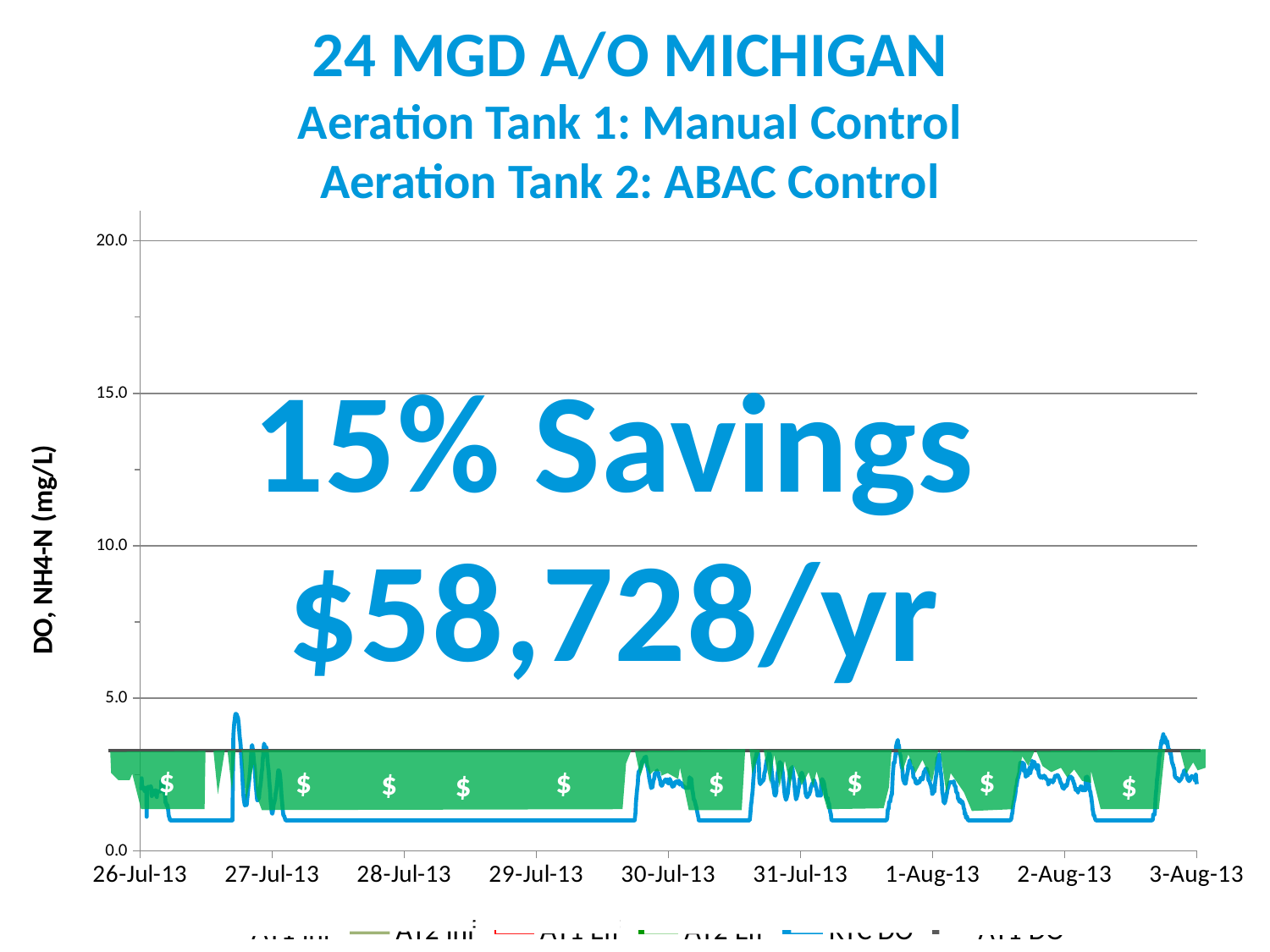
Does the blue line ever rise above 10.0 on the chart? No How many "$" symbols are printed inside the green shaded area of the chart? 9 Is the peak of the blue line near 27-Jul-13 greater or less than 5.0? less What kind of chart is shown on the slide? line chart How many date labels are shown along the horizontal axis of the chart? 9 What percentage savings is printed over the chart? 15% Is the blue line on 29-Jul-13 greater or less than 5.0? less What annual dollar savings figure is printed over the chart? $58,728/yr What is the label on the vertical axis of the chart? DO, NH4-N (mg/L) What is the highest value shown on the vertical axis of the chart? 20.0 What is the last date shown on the horizontal axis of the chart? 3-Aug-13 What is the first date shown on the horizontal axis of the chart? 26-Jul-13